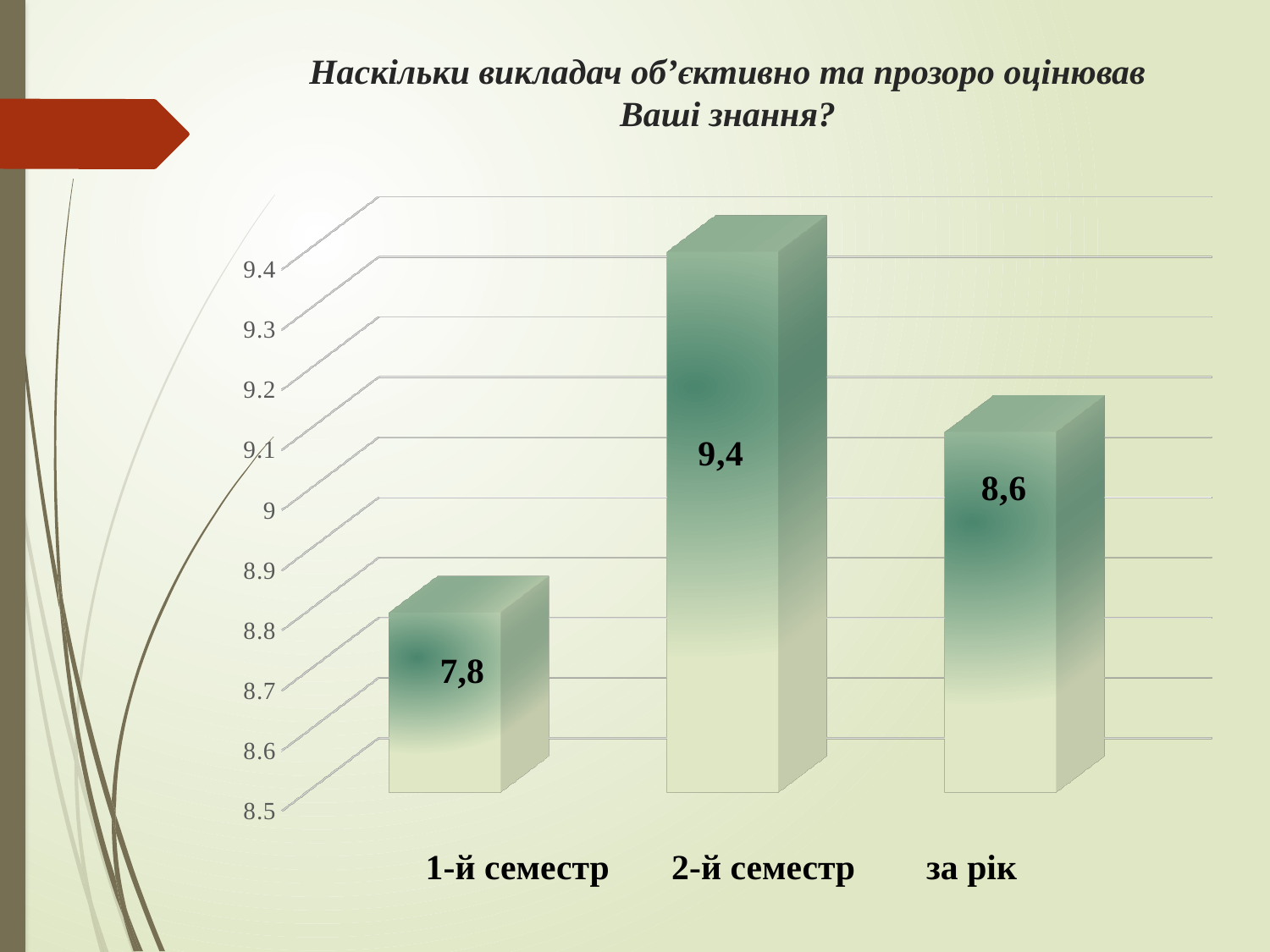
Which category has the highest value? 2-й семестр What is the value for 2-й семестр? 9,4 How many categories are shown on the chart? 3 What is the difference between the values for 2-й семестр and 1-й семестр? 1,6 What kind of chart is shown on the slide? bar chart What is the difference between the values for 2-й семестр and за рік? 0,8 Which is larger, the value for за рік or the value for 1-й семестр? за рік What is the value for 1-й семестр? 7,8 Which category has the lowest value? 1-й семестр Is the value for 2-й семестр greater or less than 9? greater What is the value for за рік? 8,6 Does the value rise or fall from 1-й семестр to 2-й семестр? rise